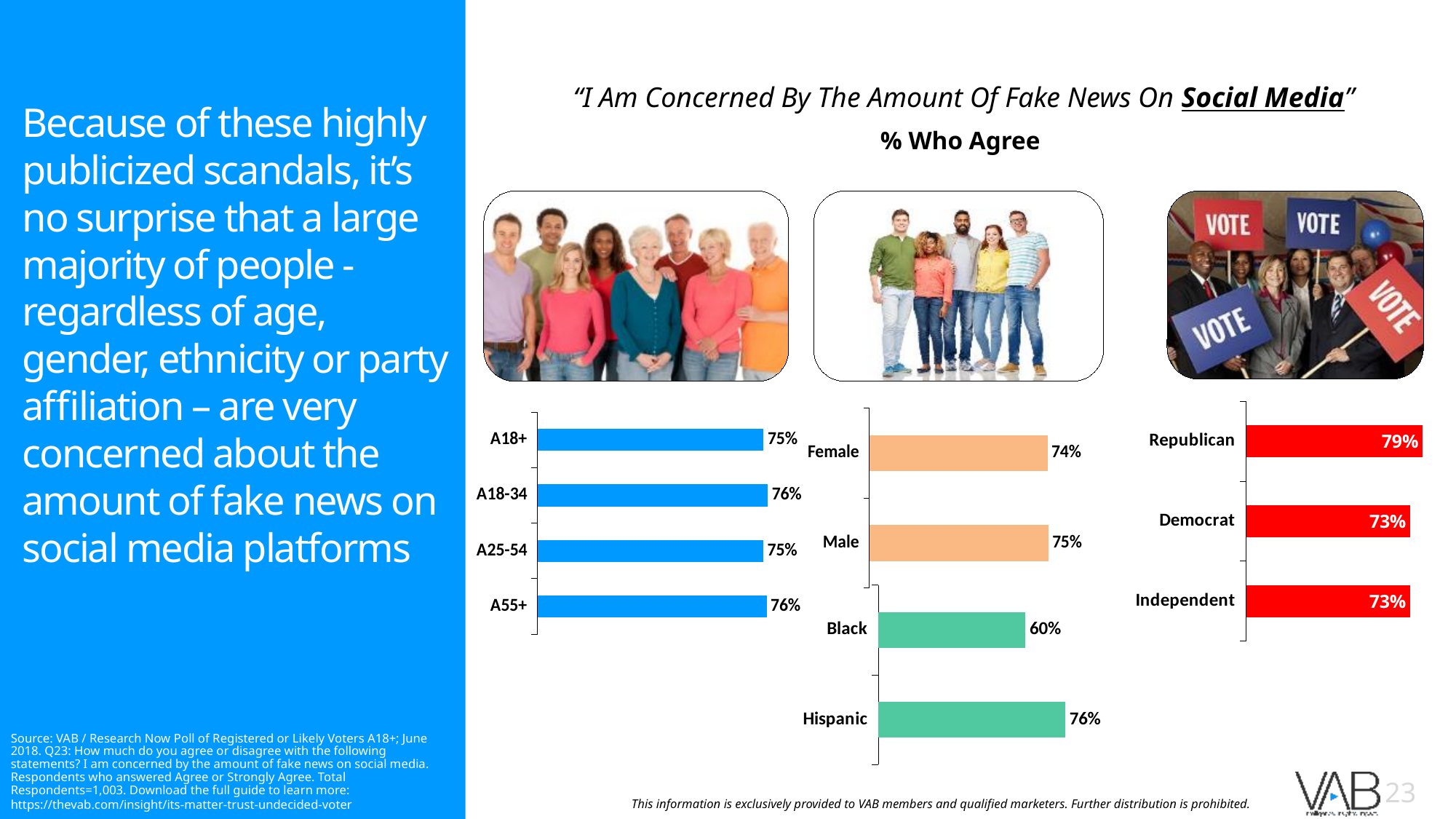
In the ethnicity chart in the middle, what is the difference between the Hispanic and Black values? 16% In the party affiliation chart on the right, what percentage of Republicans agree? 79% In the party affiliation chart on the right, what is the difference between the Republican and Democrat values? 6% What type of chart is used for the party affiliation data on the right? Bar chart In the gender chart in the middle, what percentage of Female respondents agree? 74% In the age chart on the left, what percentage of A25-54 agree? 75% What colour are the bars in the party affiliation chart on the right? Red In the party affiliation chart on the right, which category has the highest value? Republican In the ethnicity chart in the middle, what percentage of Black respondents agree? 60% In the age chart on the left, what percentage of A18-34 agree? 76% In the gender chart in the middle, which is larger, the Female value or the Male value? Male How many age categories are shown in the age chart on the left? 4